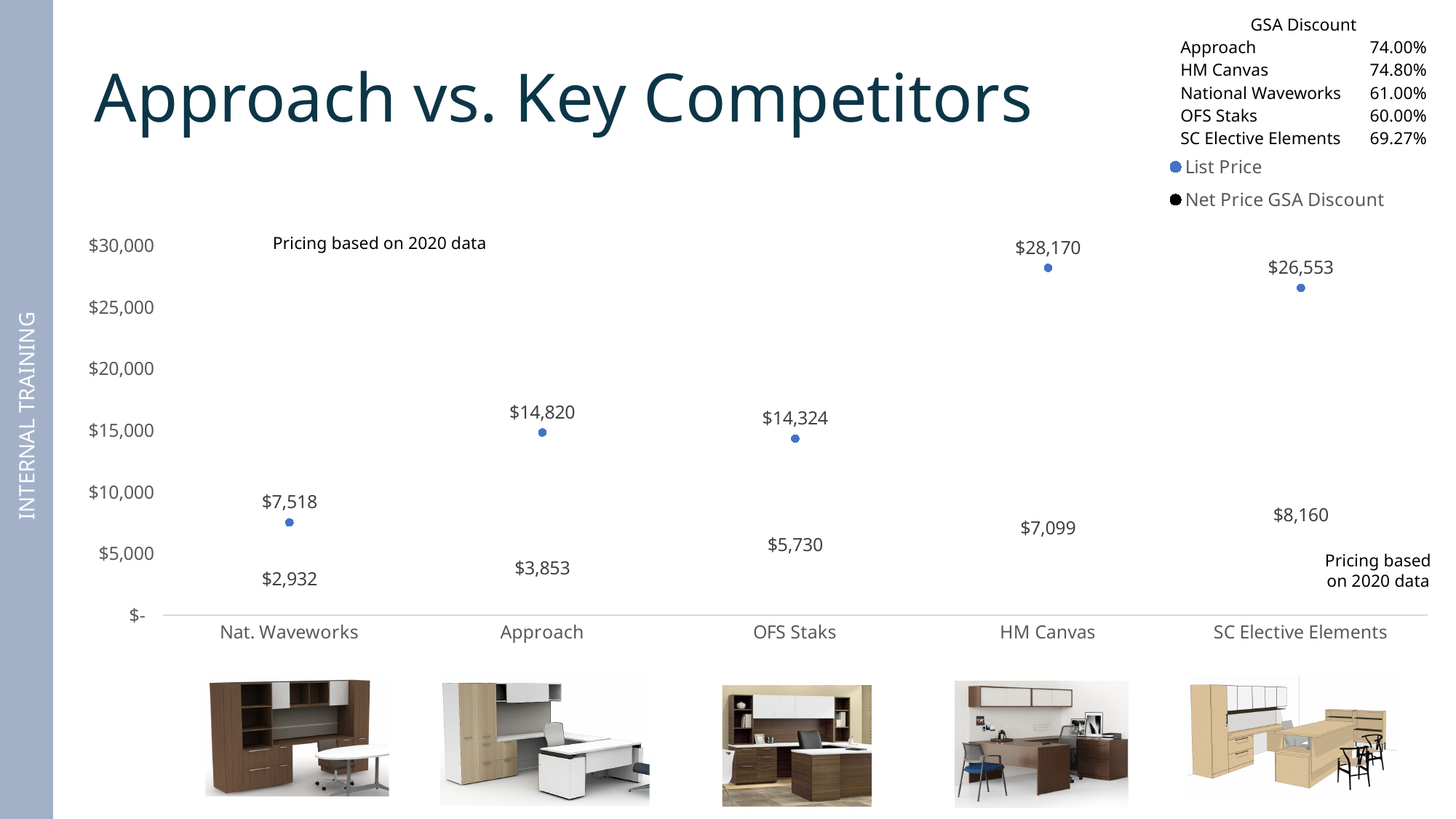
How many series does the legend list? 2 What is the List Price for Nat. Waveworks? $7,518 How many categories are shown on the x axis? 5 What is the title of the slide containing the chart? Approach vs. Key Competitors Is the List Price for SC Elective Elements greater or less than $25,000? greater Which category has the highest List Price? HM Canvas Which has a higher List Price, Approach or OFS Staks? Approach Which category has the lowest Net Price GSA Discount? Nat. Waveworks What is the difference between the List Price and the Net Price GSA Discount for OFS Staks? $8,594 What is the List Price for HM Canvas? $28,170 What is the Net Price GSA Discount for SC Elective Elements? $8,160 What is the Net Price GSA Discount for Approach? $3,853